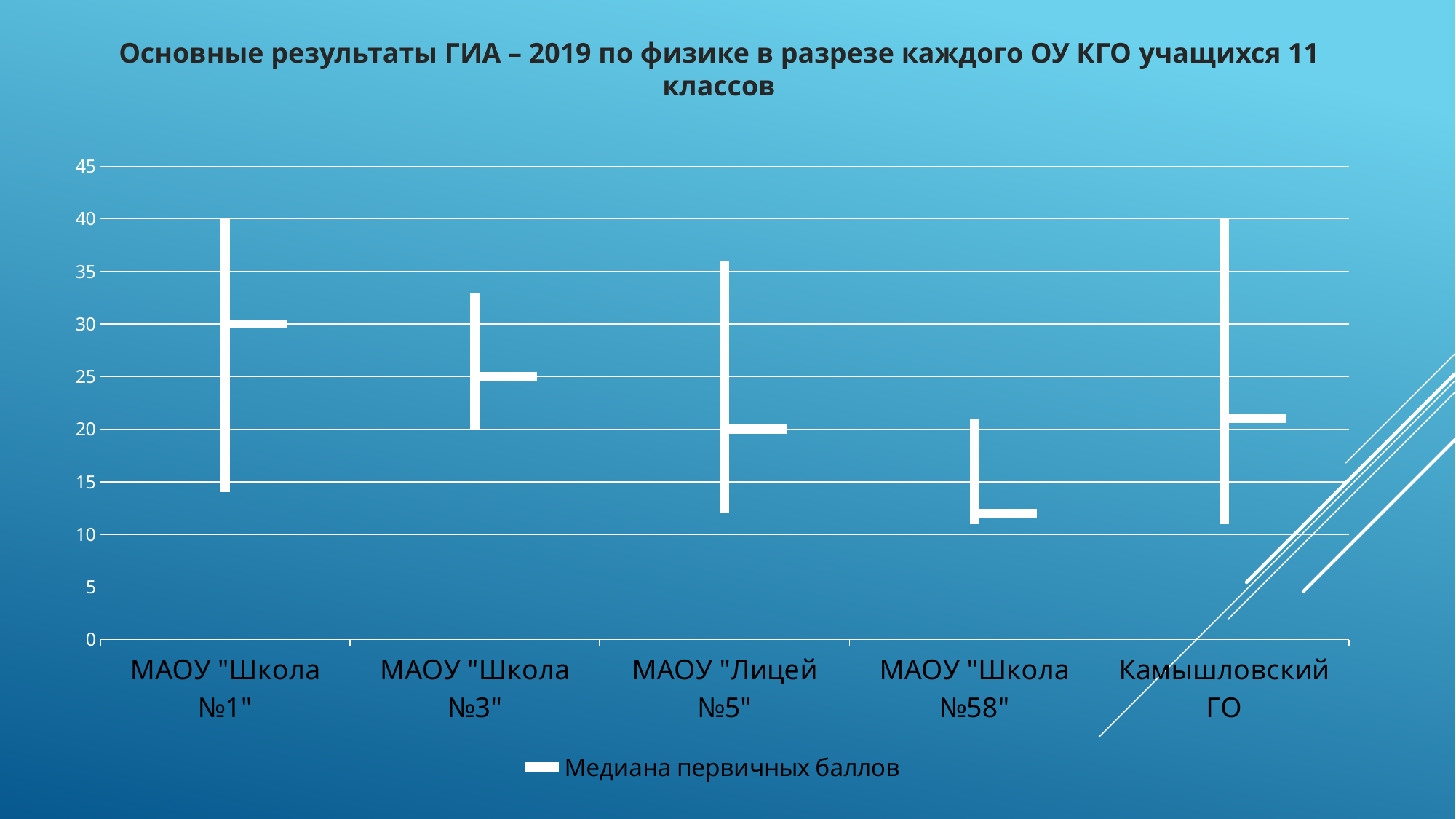
How many educational institutions (categories) are shown on the x axis? 5 How many series does the legend list? 1 What is the median primary score for МАОУ "Лицей №5"? 20 What is the legend entry of the chart? Медиана первичных баллов Which has a higher median primary score, МАОУ "Школа №3" or МАОУ "Лицей №5"? МАОУ "Школа №3" What is the median primary score (Медиана первичных баллов) for МАОУ "Школа №1"? 30 What is the difference between the median primary scores of МАОУ "Школа №1" and МАОУ "Школа №3"? 5 Is the median primary score for МАОУ "Школа №58" greater or less than 15? less What is the median primary score for МАОУ "Школа №3"? 25 Which school has the highest median primary score? МАОУ "Школа №1" Which school has the lowest median primary score? МАОУ "Школа №58" Is the median primary score for Камышловский ГО greater or less than 20? greater